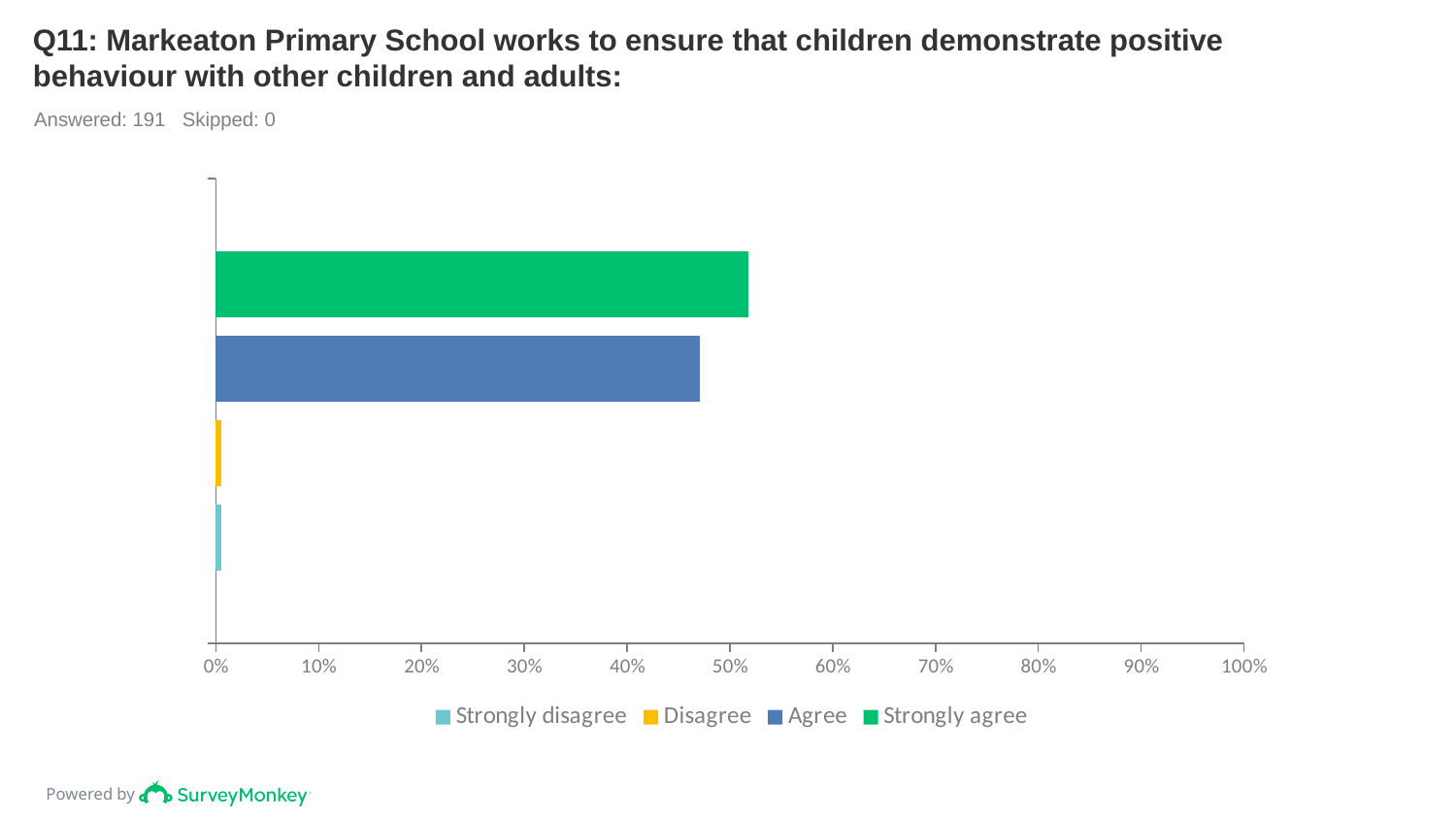
Is the value for Agree greater or less than 50%? less Is the value for Strongly agree greater or less than 50%? greater What colour is the bar for Strongly agree? green What kind of chart is shown on the slide? bar chart Is the value for Disagree greater or less than 10%? less How many respondents answered this question according to the slide? 191 Which is larger, the value for Strongly agree or the value for Agree? Strongly agree Which is larger, the value for Agree or the value for Disagree? Agree Which response option has the highest value? Strongly agree How many series does the legend list? 4